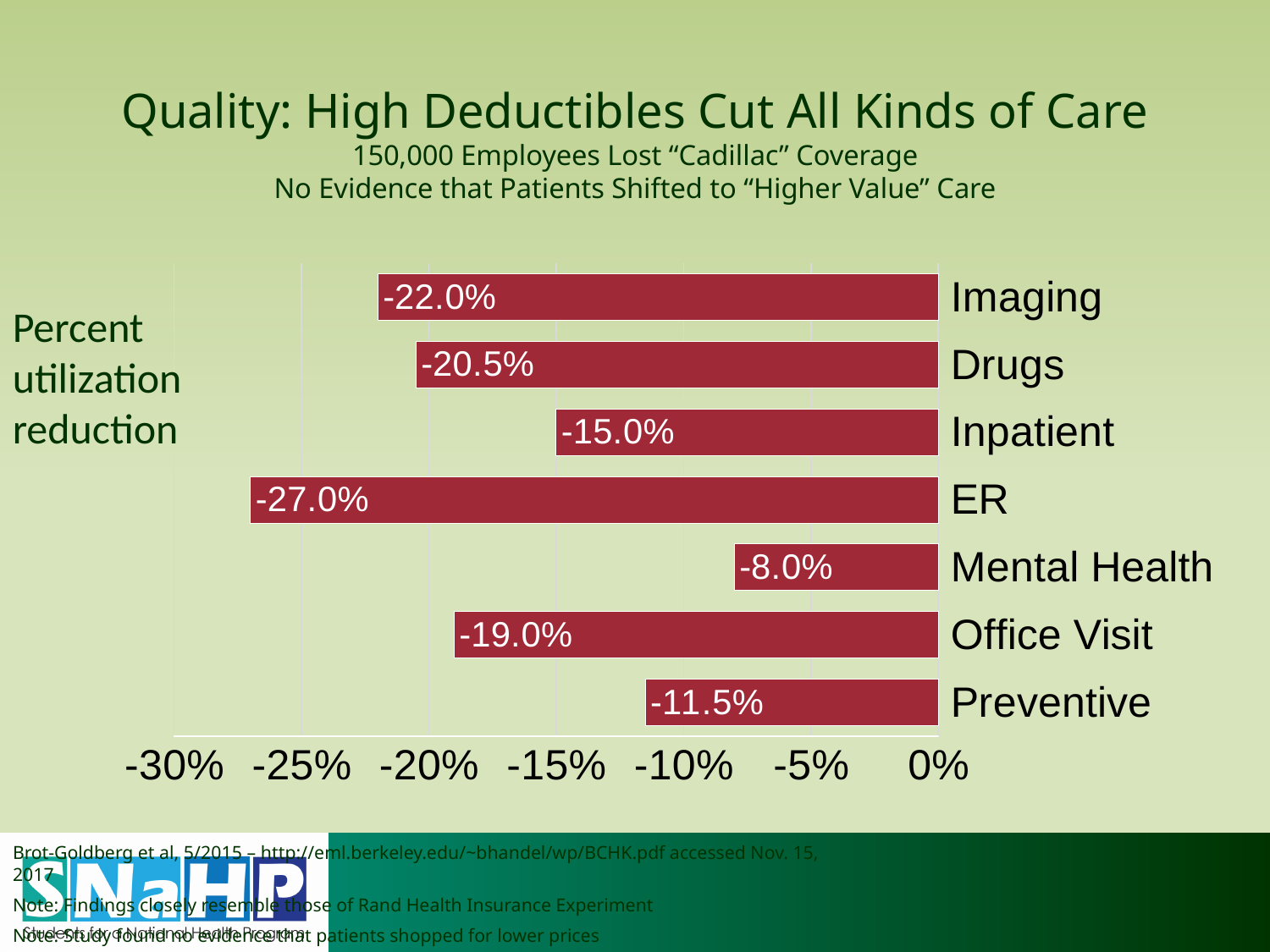
What is the percent utilization reduction for Imaging? -22.0% What kind of chart is shown on the slide? Bar chart Which category shows the largest utilization reduction? ER What is the difference between the Office Visit and Preventive reductions? 7.5 percentage points Which category shows the smallest utilization reduction? Mental Health What is the value shown for Drugs? -20.5% What is the title of the slide containing the chart? Quality: High Deductibles Cut All Kinds of Care What is the value shown for Preventive care? -11.5% What is the value shown for Mental Health? -8.0% Which has a larger utilization reduction, Inpatient or Office Visit? Office Visit How many categories of care are shown in the chart? 7 By how many percentage points does the ER reduction exceed the Mental Health reduction? 19.0 percentage points